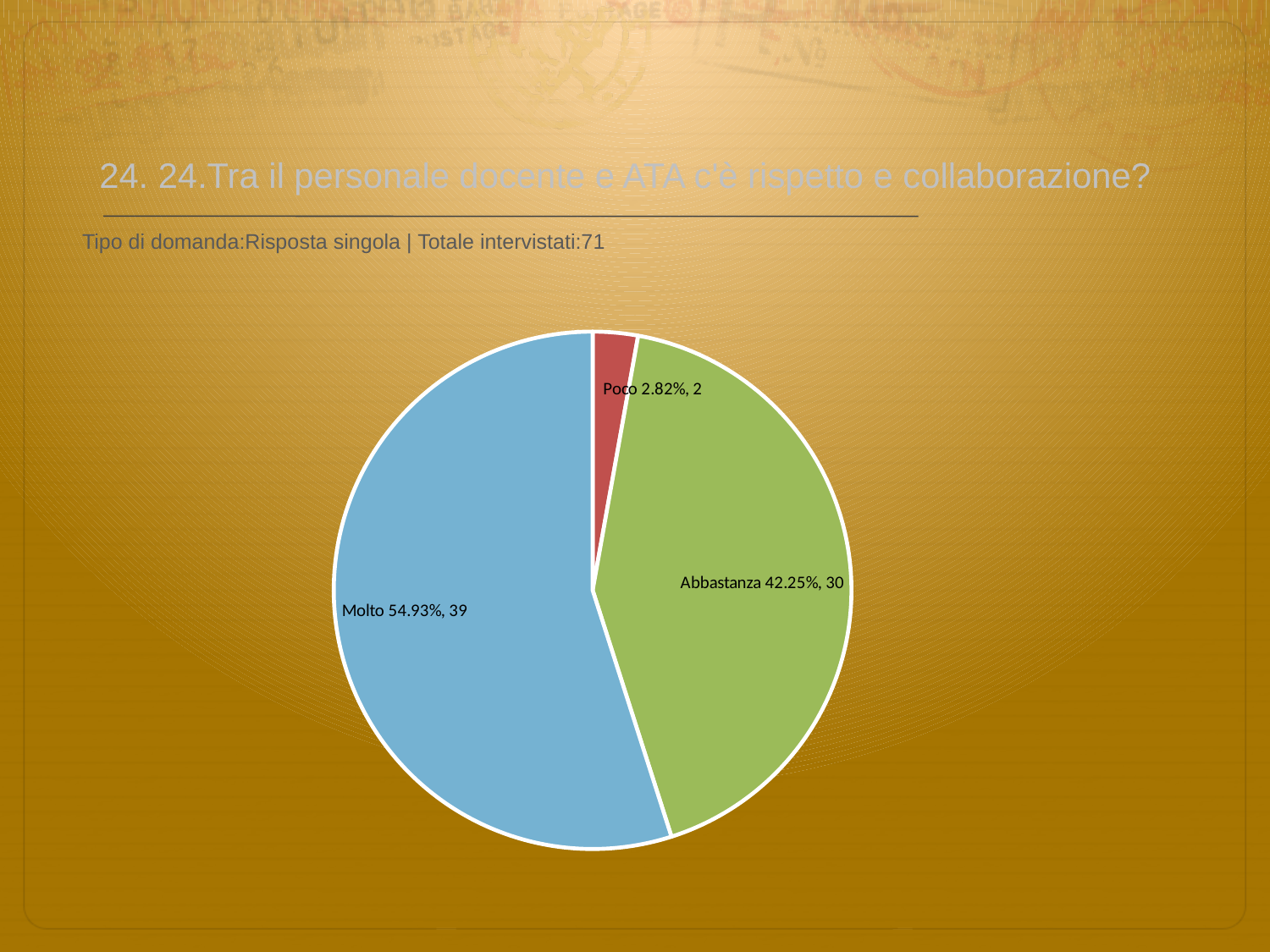
What percentage share does the Molto slice have? 54.93% How many respondents answered Abbastanza? 30 How many respondents answered Molto? 39 Which category has the largest slice? Molto What percentage share does the Poco slice have? 2.82% What kind of chart is shown on the slide? pie chart How many respondents answered Poco? 2 What is the difference in respondent count between Molto and Abbastanza? 9 What percentage share does the Abbastanza slice have? 42.25% Which slice is larger, Abbastanza or Poco? Abbastanza Which category has the smallest slice? Poco How many slices does the pie chart have? 3